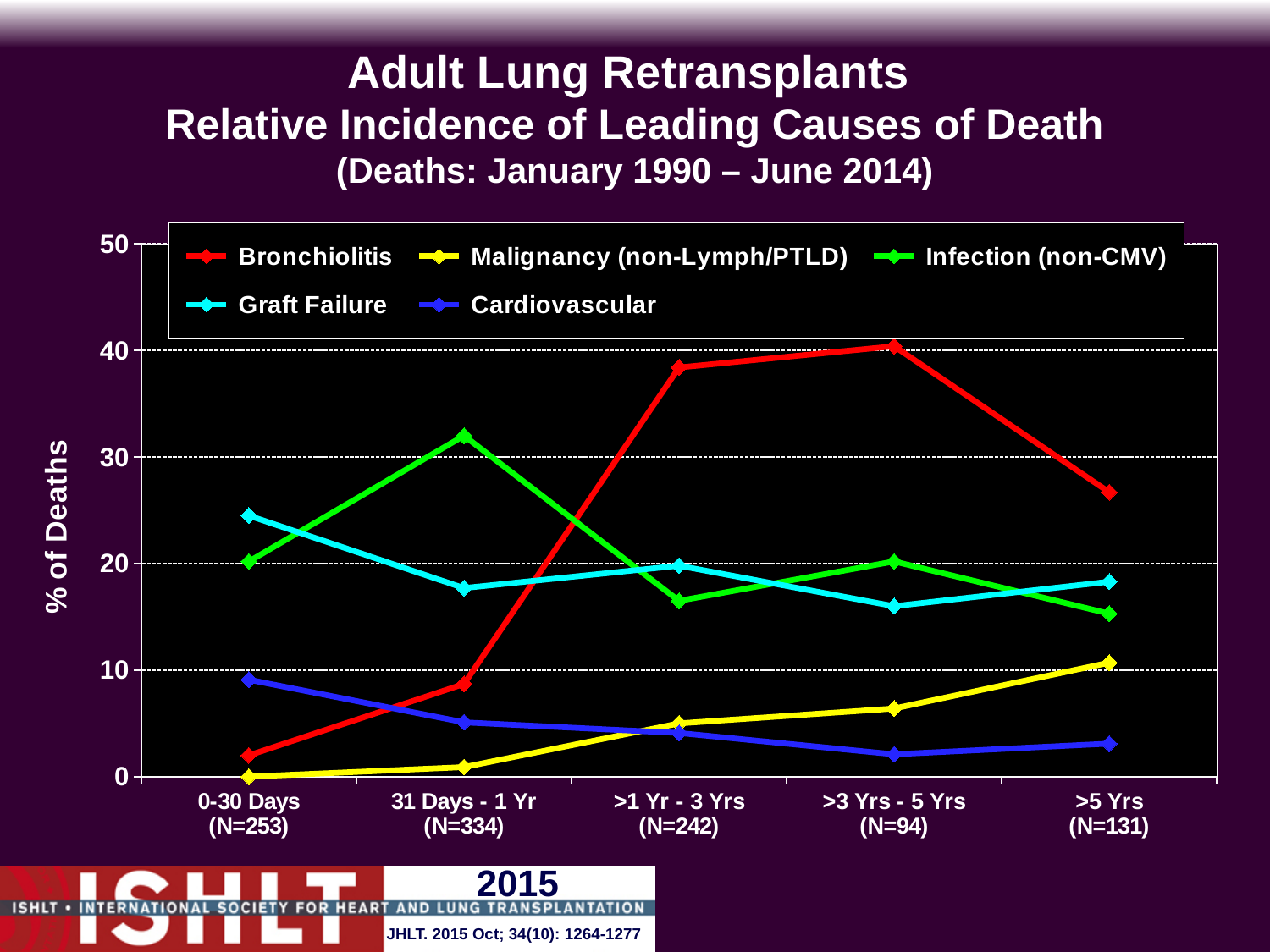
At >5 Yrs, which is larger: Graft Failure or Infection (non-CMV)? Graft Failure Is the value for Bronchiolitis at >1 Yr - 3 Yrs greater or less than 30? greater Which cause of death has the highest value at >3 Yrs - 5 Yrs? Bronchiolitis How many series does the legend list? 5 What colour is the Bronchiolitis line? red What kind of chart is shown on the slide? line chart How many time-period categories are shown on the x axis? 5 Which cause of death has the lowest value at 0-30 Days? Malignancy (non-Lymph/PTLD) Is the value for Infection (non-CMV) at 31 Days - 1 Yr greater or less than 20? greater Does the Malignancy (non-Lymph/PTLD) line rise or fall from 0-30 Days to >5 Yrs? rises Is the value for Cardiovascular at 0-30 Days greater or less than 10? less Which cause of death has the highest value at 0-30 Days? Graft Failure